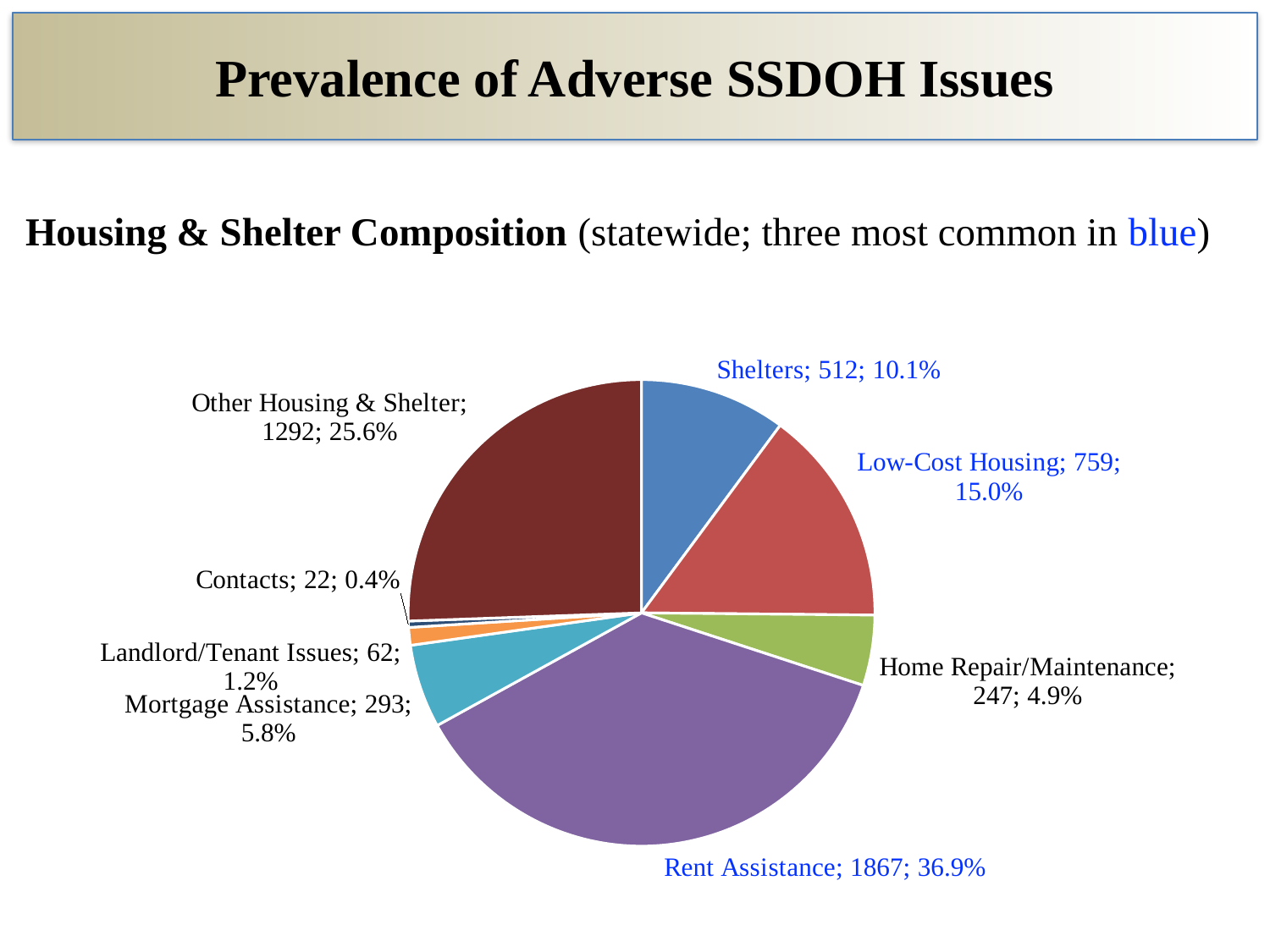
Which category has the smallest slice of the pie? Contacts Which is larger, Mortgage Assistance or Home Repair/Maintenance? Mortgage Assistance What percentage share does Low-Cost Housing have? 15.0% What kind of chart is shown on the slide? pie chart Which category has the largest slice of the pie? Rent Assistance How many categories are shown in the pie chart? 8 What colour are the labels of the three most common categories shown in? blue What is the count for Shelters? 512 What is the difference in count between Shelters and Home Repair/Maintenance? 265 What is the difference in count between Other Housing & Shelter and Low-Cost Housing? 533 What percentage share does Landlord/Tenant Issues have? 1.2% What is the count for Rent Assistance? 1867